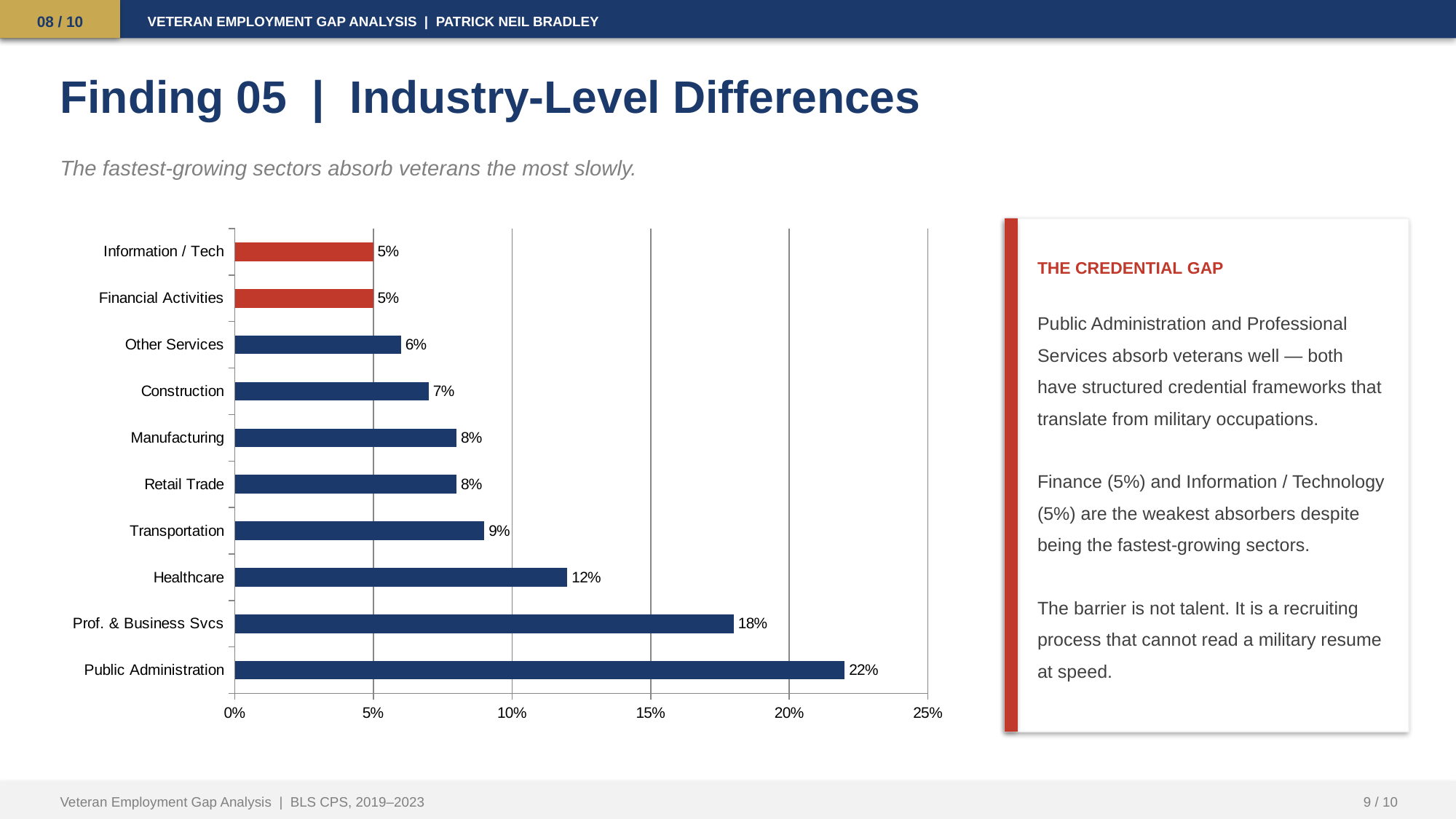
Which category has the highest value? Public Administration How many categories are shown in the chart? 10 What is the value for Healthcare? 12% Is the value for Prof. & Business Svcs greater or less than 15%? greater Which is larger, Manufacturing or Other Services? Manufacturing What is the maximum value shown on the x axis? 25% What is the value for Public Administration? 22% What is the value for Construction? 7% What is the difference between Healthcare and Transportation? 3% What kind of chart is shown on the slide? Bar chart Which two categories are shown with red bars? Information / Tech and Financial Activities What is the difference between Public Administration and Prof. & Business Svcs? 4%